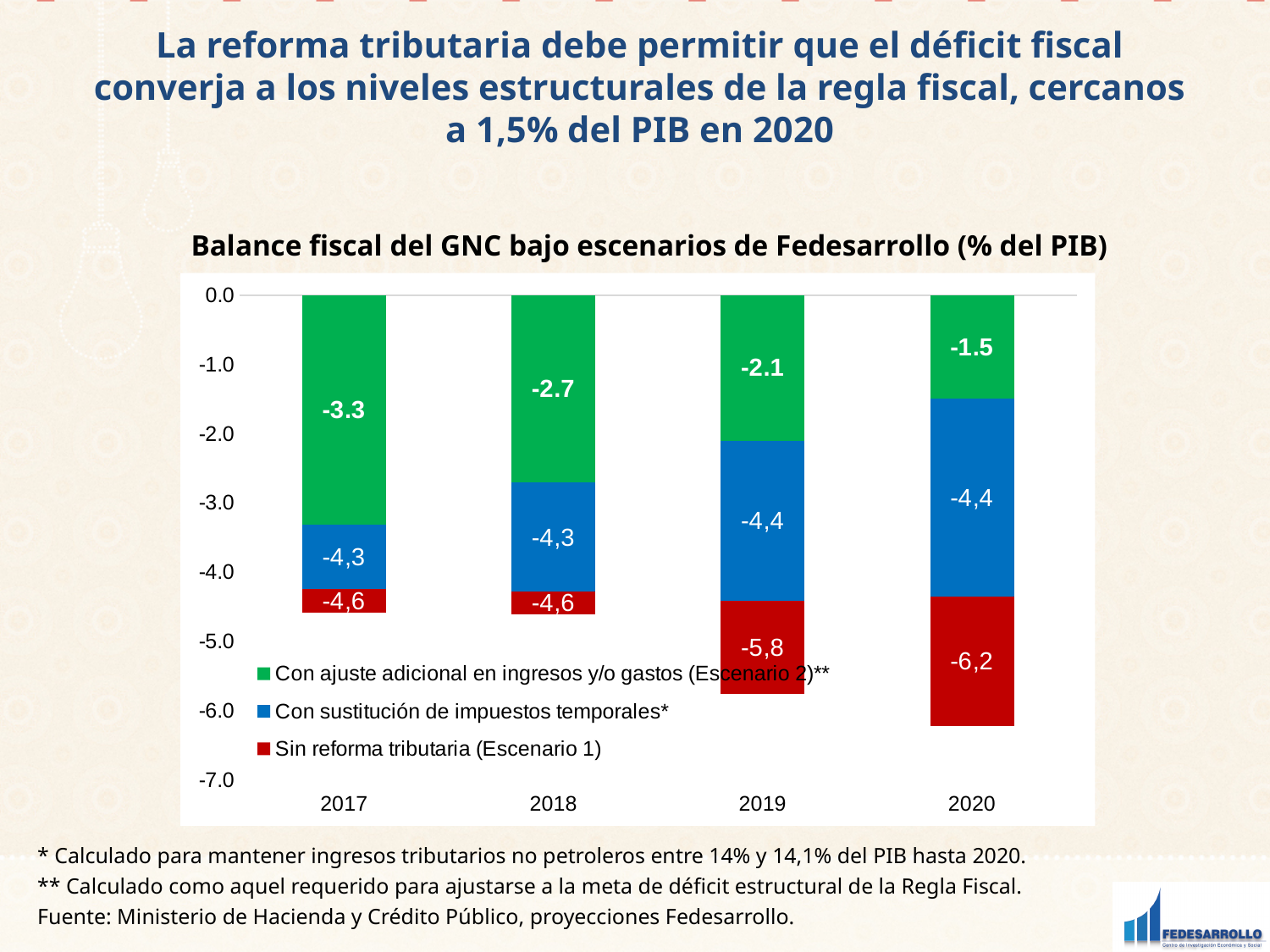
What is the value for 'Con ajuste adicional en ingresos y/o gastos (Escenario 2)**' in 2017? -3.3 Does the value for 'Con ajuste adicional en ingresos y/o gastos (Escenario 2)**' rise or fall from 2017 to 2020? Rise What is the value for 'Sin reforma tributaria (Escenario 1)' in 2019? -5,8 What is the value for 'Sin reforma tributaria (Escenario 1)' in 2020? -6,2 What kind of chart is shown? Bar chart In which year is the value for 'Sin reforma tributaria (Escenario 1)' lowest? 2020 In which year is the value for 'Con ajuste adicional en ingresos y/o gastos (Escenario 2)**' highest? 2020 What is the value for 'Con sustitución de impuestos temporales*' in 2018? -4,3 Which is larger in 2019: the value for 'Con sustitución de impuestos temporales*' or the value for 'Sin reforma tributaria (Escenario 1)'? Con sustitución de impuestos temporales* How many years are shown on the x axis? 4 What is the value for 'Con ajuste adicional en ingresos y/o gastos (Escenario 2)**' in 2020? -1.5 How many series does the legend list? 3